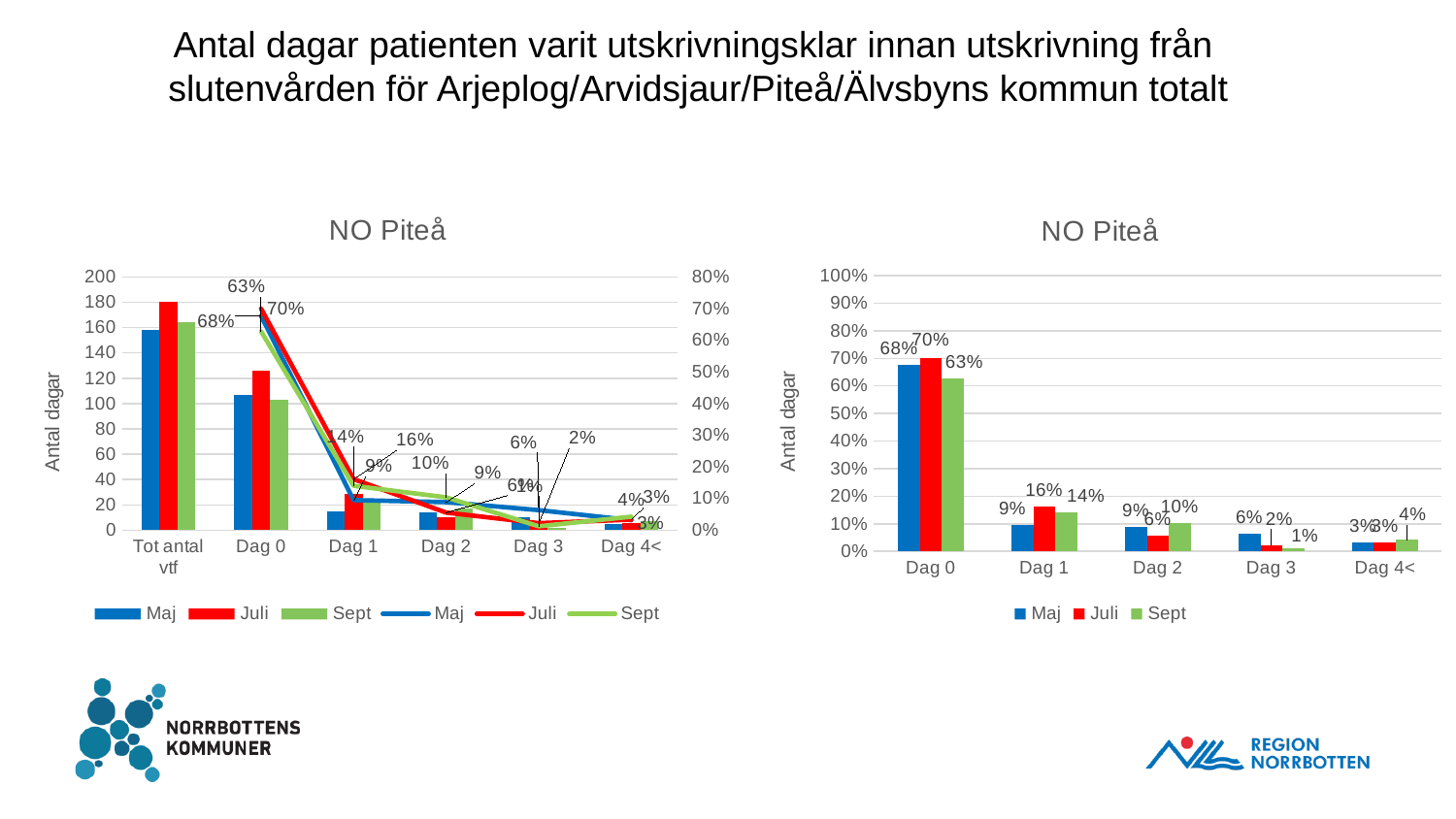
In the right-hand chart, which is larger for Dag 1, the Juli value or the Sept value? Juli In the right-hand chart, what is the Sept value for Dag 1? 14% How many categories are shown on the x axis of the right-hand chart? 5 In the left-hand chart, is the Maj bar for Dag 0 greater or less than 120? less In the right-hand chart, what is the difference between the Juli and Sept values for Dag 0? 7% In the right-hand chart, what is the Sept value for Dag 3? 1% How many categories are shown on the x axis of the left-hand chart? 6 In the right-hand chart, what is the Juli value for Dag 0? 70% How many series does the legend of the right-hand chart list? 3 In the right-hand chart, which category has the lowest Sept value? Dag 3 In the left-hand chart, is the Juli bar for Tot antal vtf greater or less than 160? greater In the right-hand chart, which category has the highest Maj value? Dag 0